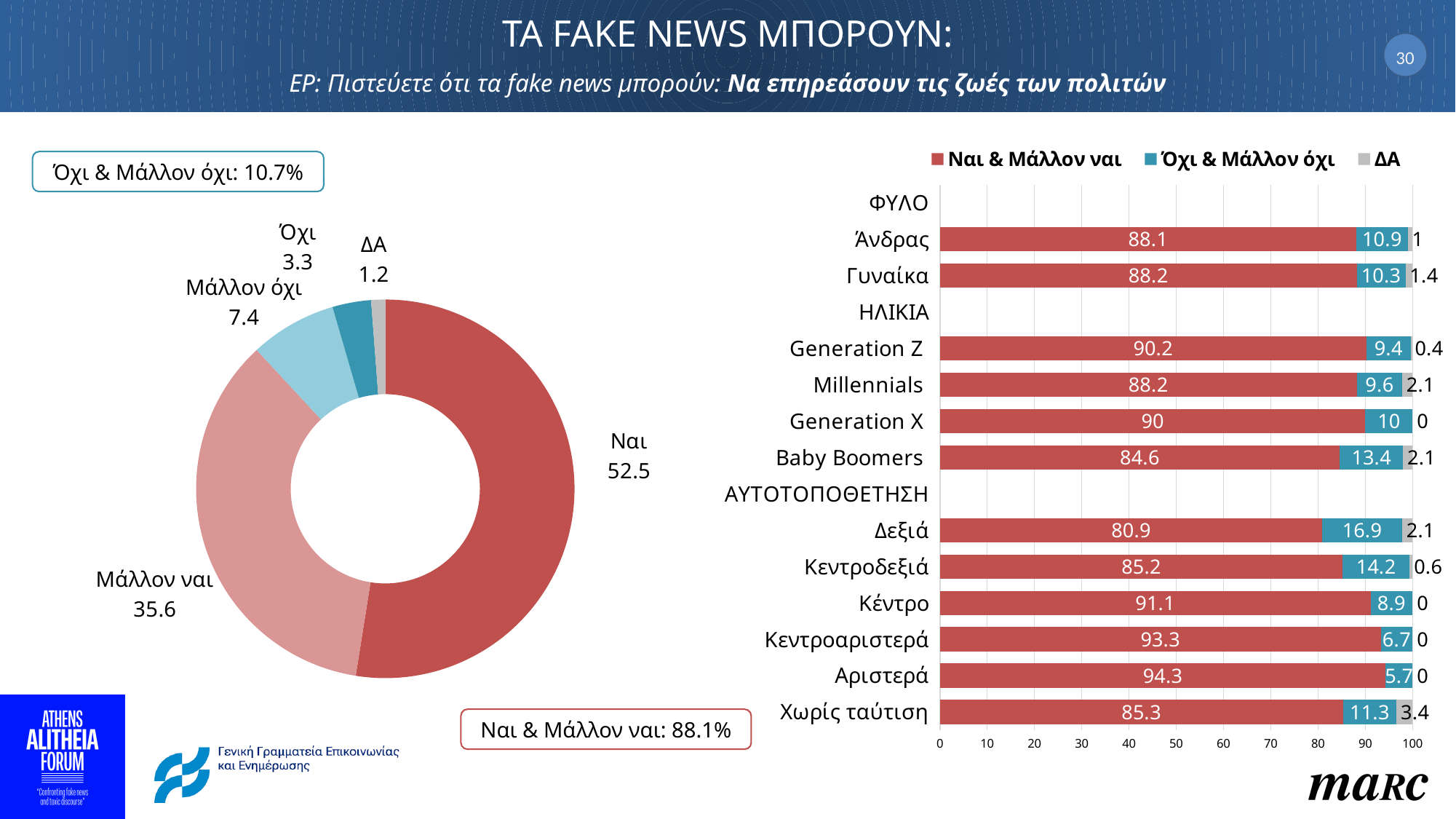
In the donut chart on the left, what is the value for Μάλλον όχι? 7.4 In the stacked bar chart on the right, how many series does the legend list? 3 In the donut chart on the left, what is the difference between Ναι and Μάλλον ναι? 16.9 In the stacked bar chart on the right, which category has the lowest Ναι & Μάλλον ναι value? Δεξιά In the stacked bar chart on the right, what is the Όχι & Μάλλον όχι value for Δεξιά? 16.9 In the stacked bar chart on the right, is the Όχι & Μάλλον όχι value larger for Generation Z or for Baby Boomers? Baby Boomers In the donut chart on the left, what is the value for Ναι? 52.5 In the donut chart on the left, how many slices are there? 5 What kind of chart is shown on the right side of the slide? Stacked bar chart In the stacked bar chart on the right, which category has the highest Ναι & Μάλλον ναι value? Αριστερά In the donut chart on the left, which category has the smallest slice? ΔΑ In the stacked bar chart on the right, what is the Ναι & Μάλλον ναι value for Baby Boomers? 84.6